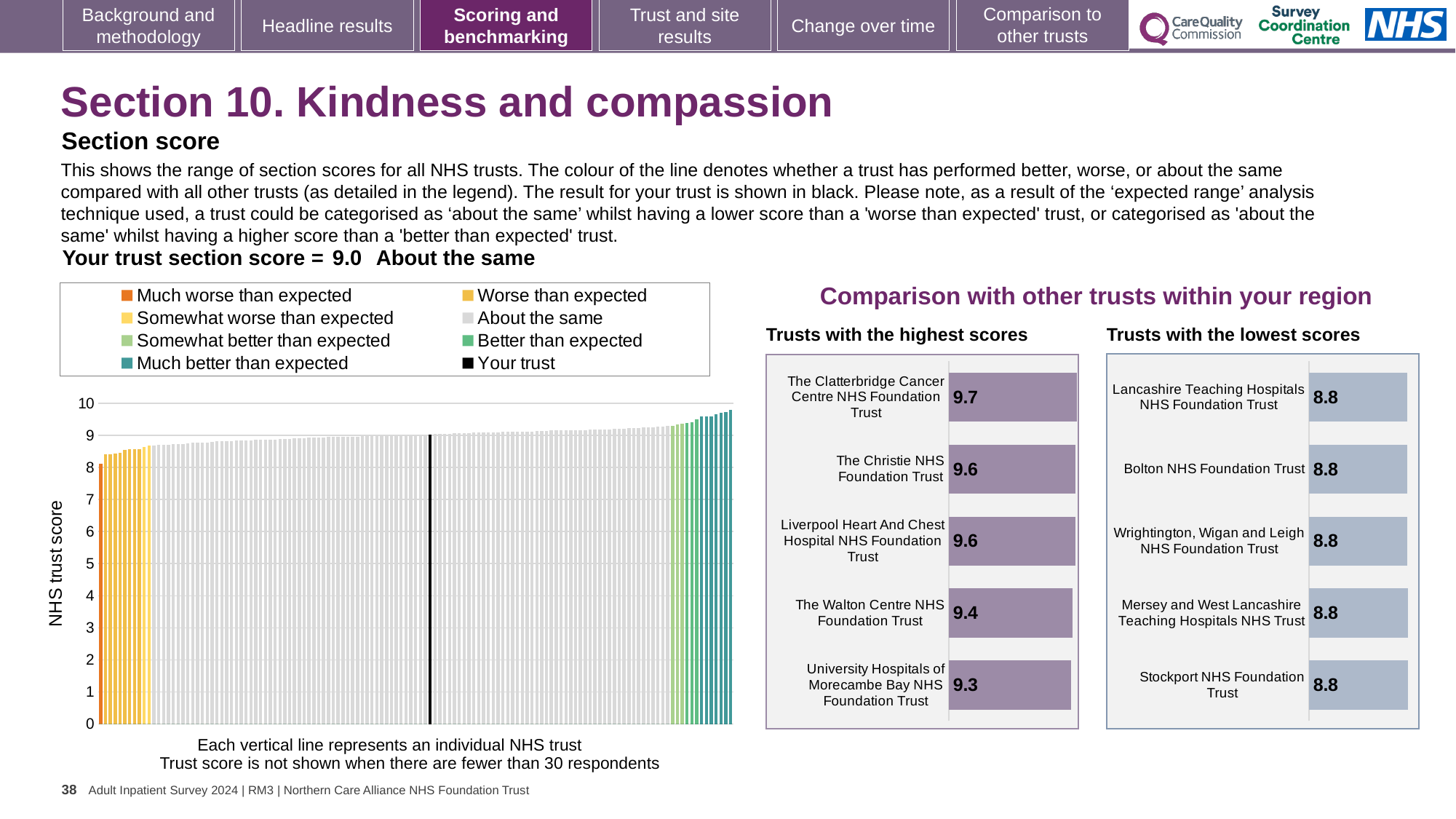
In the 'Trusts with the highest scores' chart, which trust has the highest score? The Clatterbridge Cancer Centre NHS Foundation Trust In the large chart on the left, do the trust scores rise or fall from left to right? Rise How many entries does the legend of the large chart on the left list? 8 In the 'Trusts with the highest scores' chart, what is the score for The Walton Centre NHS Foundation Trust? 9.4 In the 'Trusts with the highest scores' chart, what is the score for The Clatterbridge Cancer Centre NHS Foundation Trust? 9.7 In the 'Trusts with the lowest scores' chart, what is the score for Stockport NHS Foundation Trust? 8.8 How many trusts are shown in the 'Trusts with the lowest scores' chart? 5 In the 'Trusts with the highest scores' chart, which has the larger score: The Christie NHS Foundation Trust or The Walton Centre NHS Foundation Trust? The Christie NHS Foundation Trust In the 'Trusts with the highest scores' chart, which trust has the lowest score? University Hospitals of Morecambe Bay NHS Foundation Trust What type of chart is the large chart on the left showing NHS trust scores? Bar chart What is the difference between the score of The Clatterbridge Cancer Centre NHS Foundation Trust in the highest scores chart and Lancashire Teaching Hospitals NHS Foundation Trust in the lowest scores chart? 0.9 In the 'Trusts with the highest scores' chart, what is the difference between the scores of The Clatterbridge Cancer Centre NHS Foundation Trust and University Hospitals of Morecambe Bay NHS Foundation Trust? 0.4